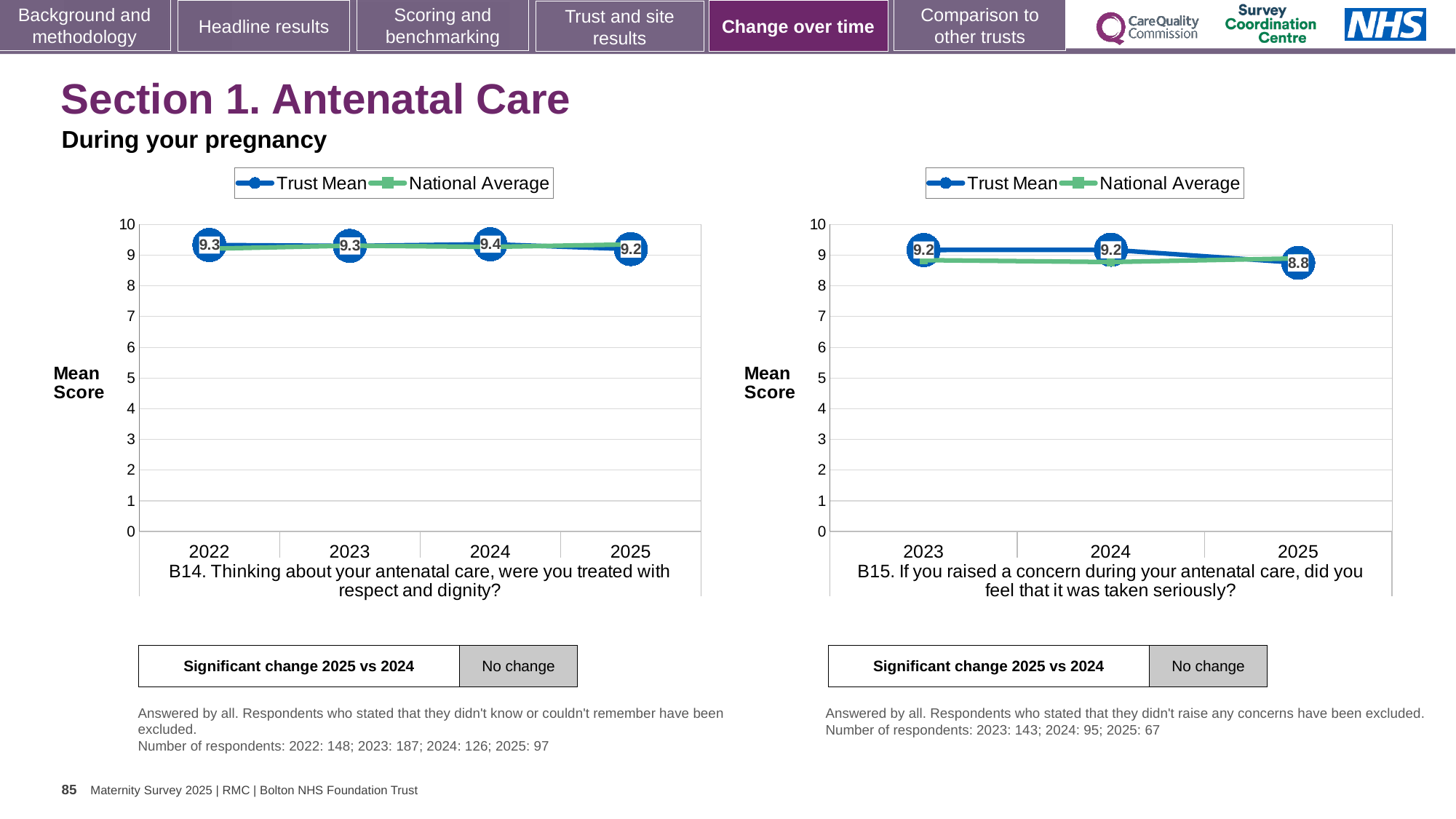
On the B14 chart (left), what is the Trust Mean for 2024? 9.4 On the B15 chart (right), what is the difference between the Trust Mean for 2024 and 2025? 0.4 On the B15 chart (right), what is the Trust Mean for 2025? 8.8 On the B15 chart (right), how many years are shown on the x axis? 3 On the B14 chart (left), what is the difference between the Trust Mean for 2024 and 2025? 0.2 On the B14 chart (left), what is the Trust Mean for 2025? 9.2 On the B15 chart (right), what is the Trust Mean for 2023? 9.2 On the B14 chart (left), how many years are shown on the x axis? 4 How many series does the legend of the B14 chart (left) list? 2 On the B15 chart (right), which year has the lowest Trust Mean? 2025 On the B14 chart (left), which year has the highest Trust Mean? 2024 What kind of chart is the B15 chart (right)? Line chart